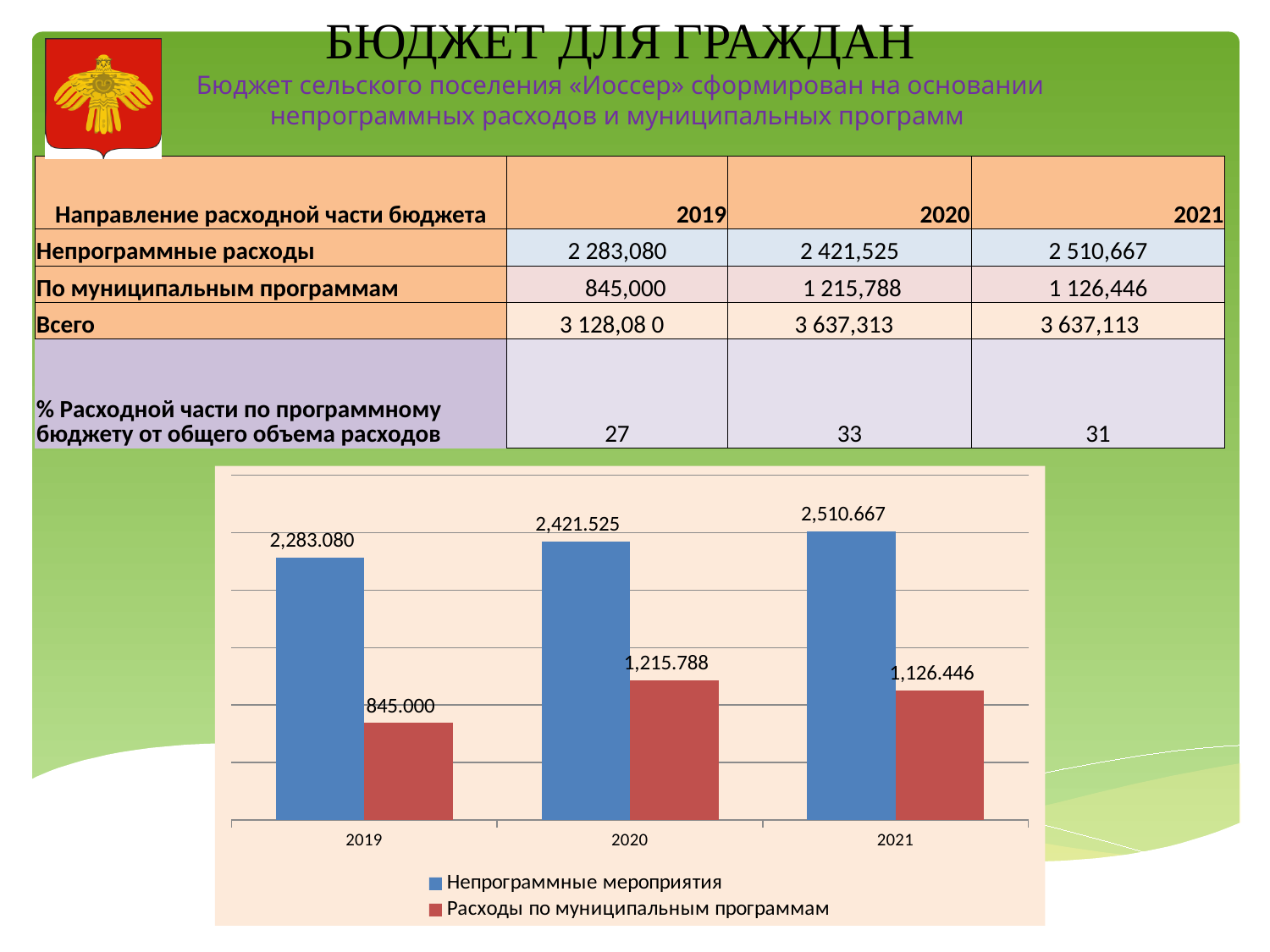
What is the value for Расходы по муниципальным программам in 2021? 1,126.446 What kind of chart is shown on the slide? bar chart What is the difference between Непрограммные мероприятия and Расходы по муниципальным программам in 2019? 1,438.080 In which year is the value for Расходы по муниципальным программам lowest? 2019 Do the values for Непрограммные мероприятия rise or fall from 2019 to 2021? rise What is the value for Непрограммные мероприятия in 2019? 2,283.080 Which is larger: Расходы по муниципальным программам in 2020 or in 2021? 2020 In which year is the value for Непрограммные мероприятия highest? 2021 How many series does the chart legend list? 2 How many years are shown on the x axis of the chart? 3 What is the difference between Непрограммные мероприятия and Расходы по муниципальным программам in 2021? 1,384.221 What is the value for Расходы по муниципальным программам in 2020? 1,215.788